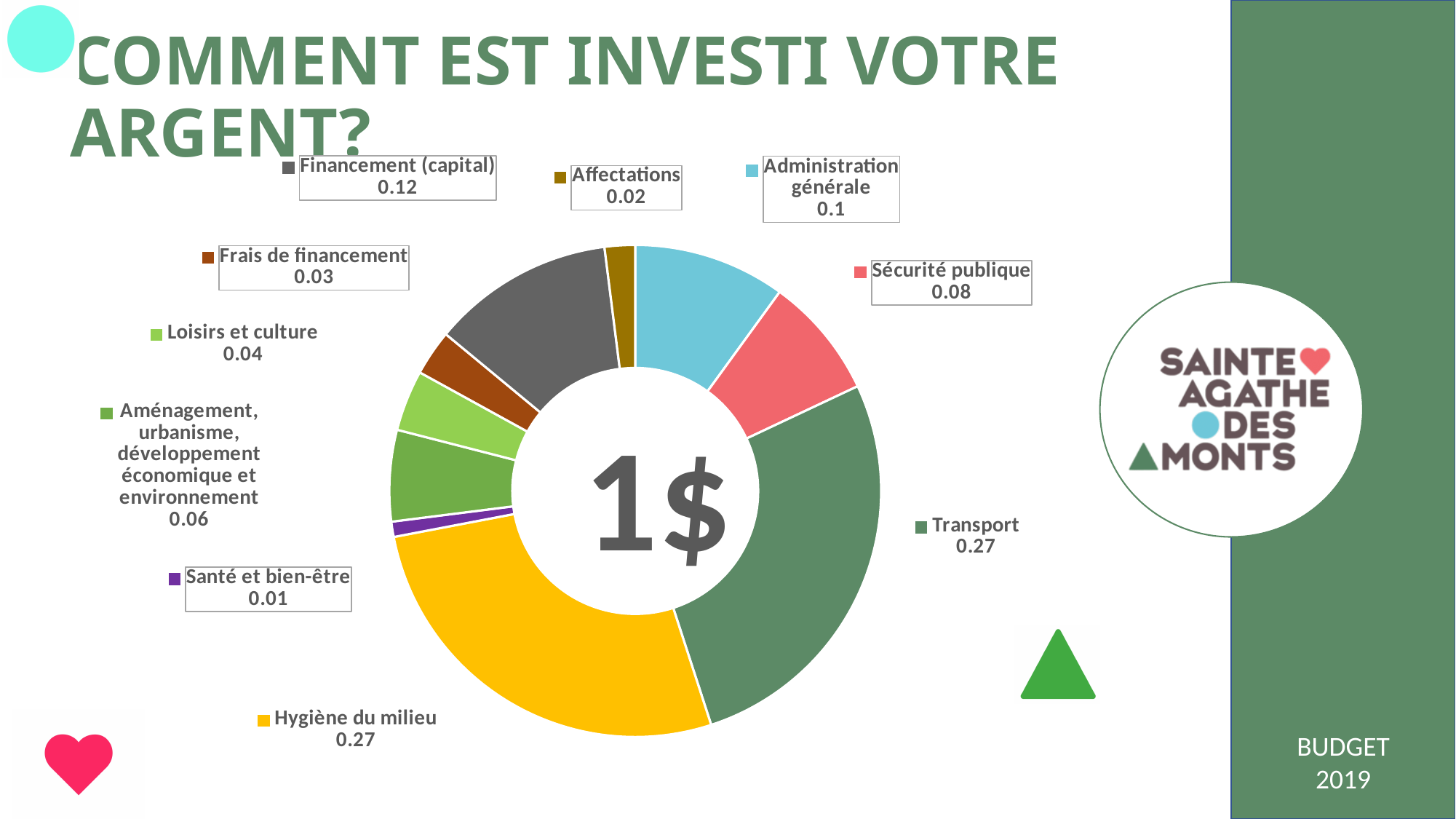
Which is larger, Sécurité publique or Affectations? Sécurité publique What kind of chart is shown on the slide? doughnut chart What text is displayed in the centre of the chart? 1$ What is the value for Loisirs et culture? 0.04 What is the value for Financement (capital)? 0.12 What is the value for Sécurité publique? 0.08 How many categories are shown in the chart? 10 What is the value for Administration générale? 0.1 Which category has the lowest value? Santé et bien-être What is the difference between the values for Transport and Administration générale? 0.17 What is the difference between the values for Financement (capital) and Frais de financement? 0.09 What is the value for Transport? 0.27